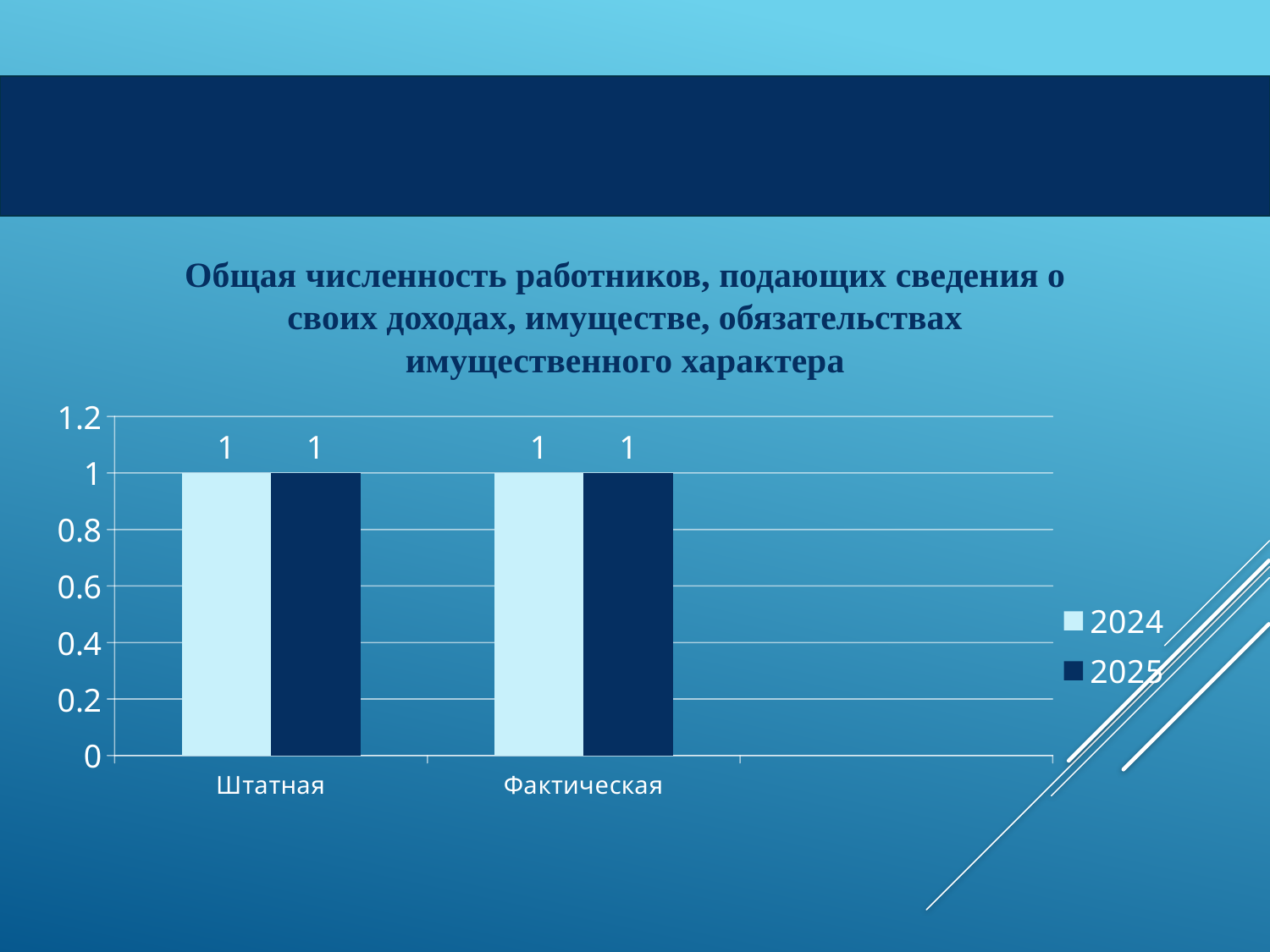
Is the value for Штатная in the 2025 series greater or less than 1.2? less What kind of chart is shown on the slide? bar chart How many categories are shown on the x axis of the chart? 2 What is the value for Штатная in the 2025 series? 1 What is the difference between the Штатная and Фактическая values in the 2025 series? 0 How many series does the legend list? 2 Which series does the dark blue colour represent in the legend? 2025 What is the value for Фактическая in the 2024 series? 1 Is the value for Фактическая in the 2024 series greater or less than 0.8? greater What is the value for Штатная in the 2024 series? 1 What is the difference between the 2024 and 2025 values for Штатная? 0 What is the value for Фактическая in the 2025 series? 1